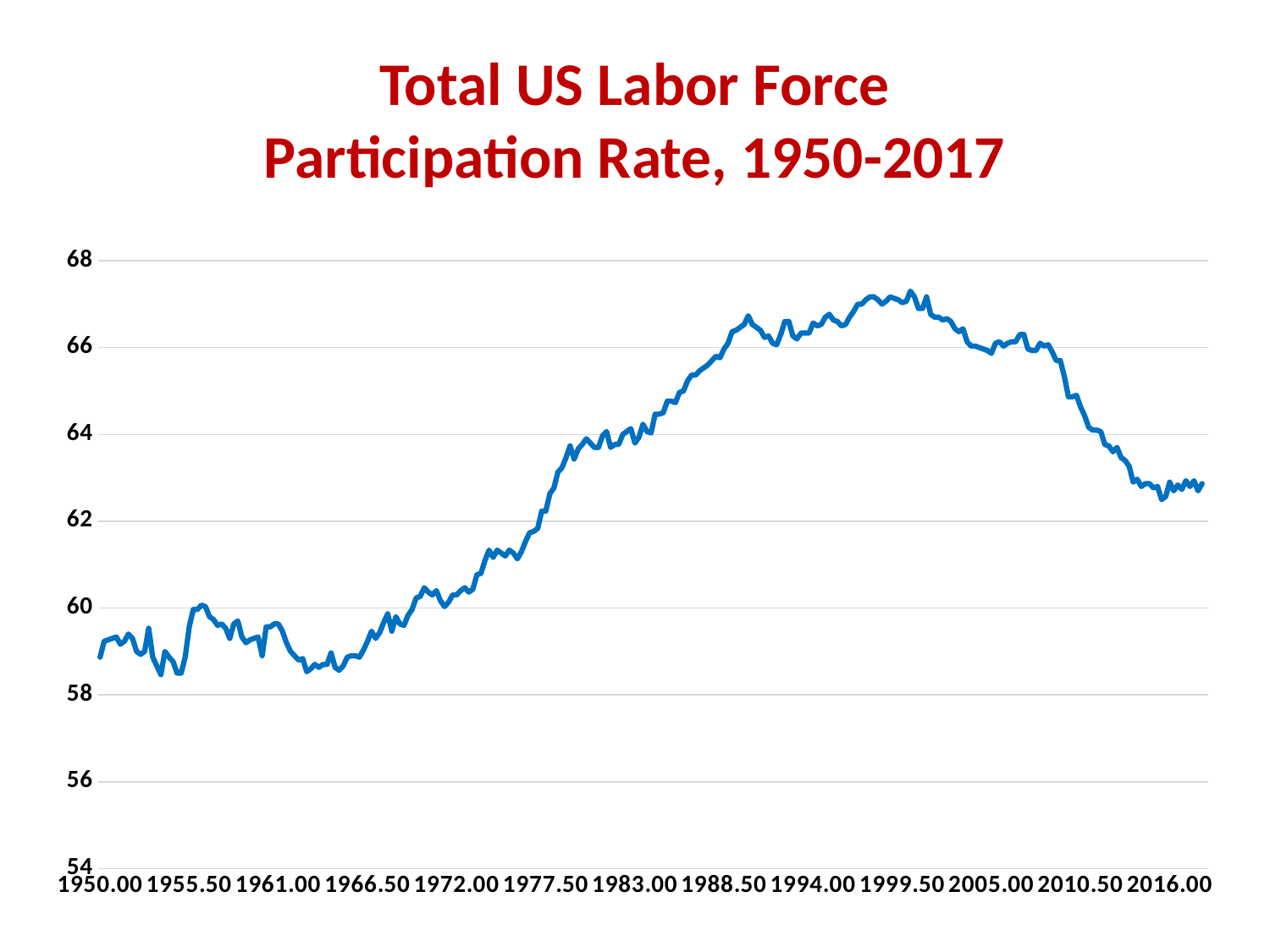
Is the value at 1999.50 greater or less than 66? greater Which is larger, the value at 1950.00 or the value at 1999.50? 1999.50 What is the title of the chart? Total US Labor Force Participation Rate, 1950-2017 What kind of chart is shown on the slide? line chart Is the value at 2016.00 greater or less than 64? less Does the line rise or fall between 1999.50 and 2016.00? fall Is the value at 2016.00 greater or less than 62? greater Does the line rise or fall between 1966.50 and 1999.50? rise Which is larger, the value at 2016.00 or the value at 1999.50? 1999.50